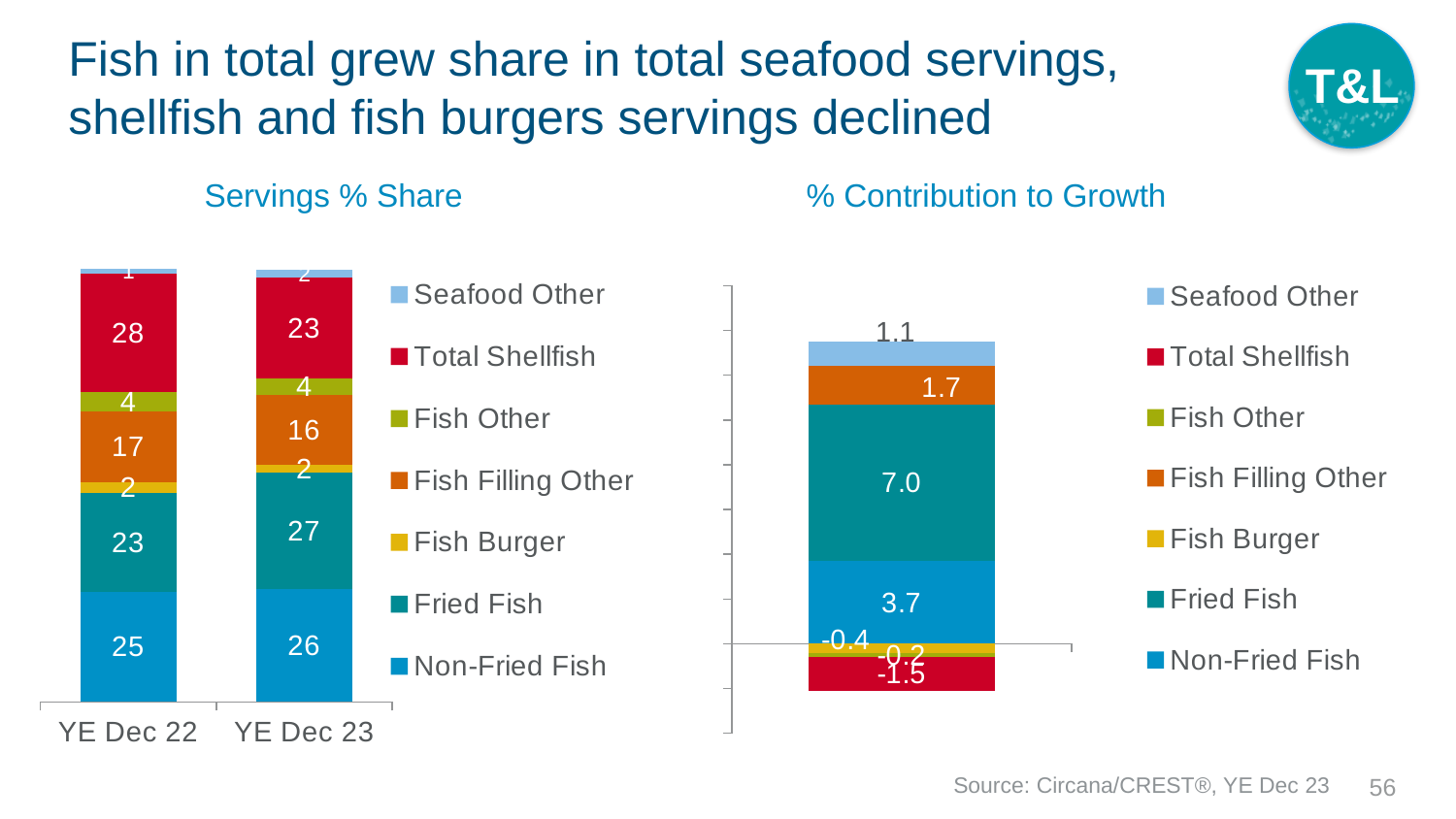
What kind of chart is the 'Servings % Share' chart? Stacked bar chart In the 'Servings % Share' chart, does the Fish Filling Other share rise or fall from YE Dec 22 to YE Dec 23? Fall In the 'Servings % Share' chart, what is the value for Total Shellfish in YE Dec 23? 23 In the '% Contribution to Growth' chart, what is the value for Fried Fish? 7.0 How many bars (time periods) are shown on the x axis of the 'Servings % Share' chart? 2 In the '% Contribution to Growth' chart, which series has the highest contribution? Fried Fish How many series does the legend of the 'Servings % Share' chart list? 7 In the 'Servings % Share' chart, is the Fried Fish share larger in YE Dec 22 or YE Dec 23? YE Dec 23 In the 'Servings % Share' chart, which series has the largest share in YE Dec 22? Total Shellfish In the '% Contribution to Growth' chart, what is the value for Total Shellfish? -1.5 In the 'Servings % Share' chart, what is the value for Non-Fried Fish in YE Dec 22? 25 In the 'Servings % Share' chart, by how much did the Total Shellfish share fall from YE Dec 22 to YE Dec 23? 5